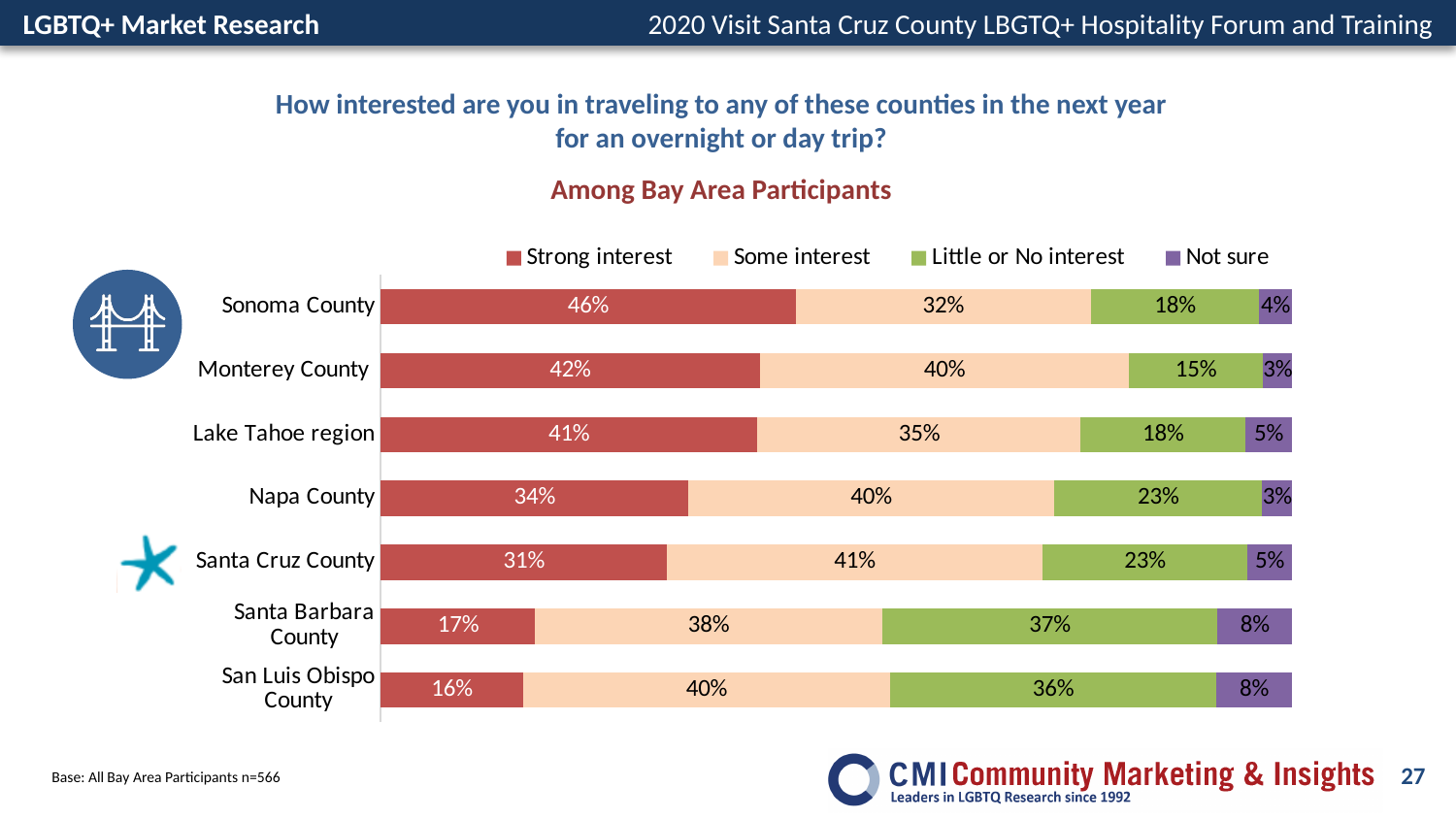
How many counties or regions are shown in the chart? 7 What percentage of Bay Area participants are not sure about traveling to San Luis Obispo County? 8% What is the difference in strong interest between Sonoma County and Santa Cruz County? 15% Which has a larger share of little or no interest, Santa Barbara County or Napa County? Santa Barbara County What kind of chart is shown on the slide? Stacked bar chart What percentage of Bay Area participants have strong interest in traveling to Sonoma County? 46% How many series does the legend list? 4 Which legend entry is shown in green? Little or No interest Which county has the lowest share of strong interest? San Luis Obispo County Which county or region has the highest share of strong interest? Sonoma County What percentage of Bay Area participants have some interest in traveling to Santa Cruz County? 41% What is the combined share of strong interest and some interest for Monterey County? 82%